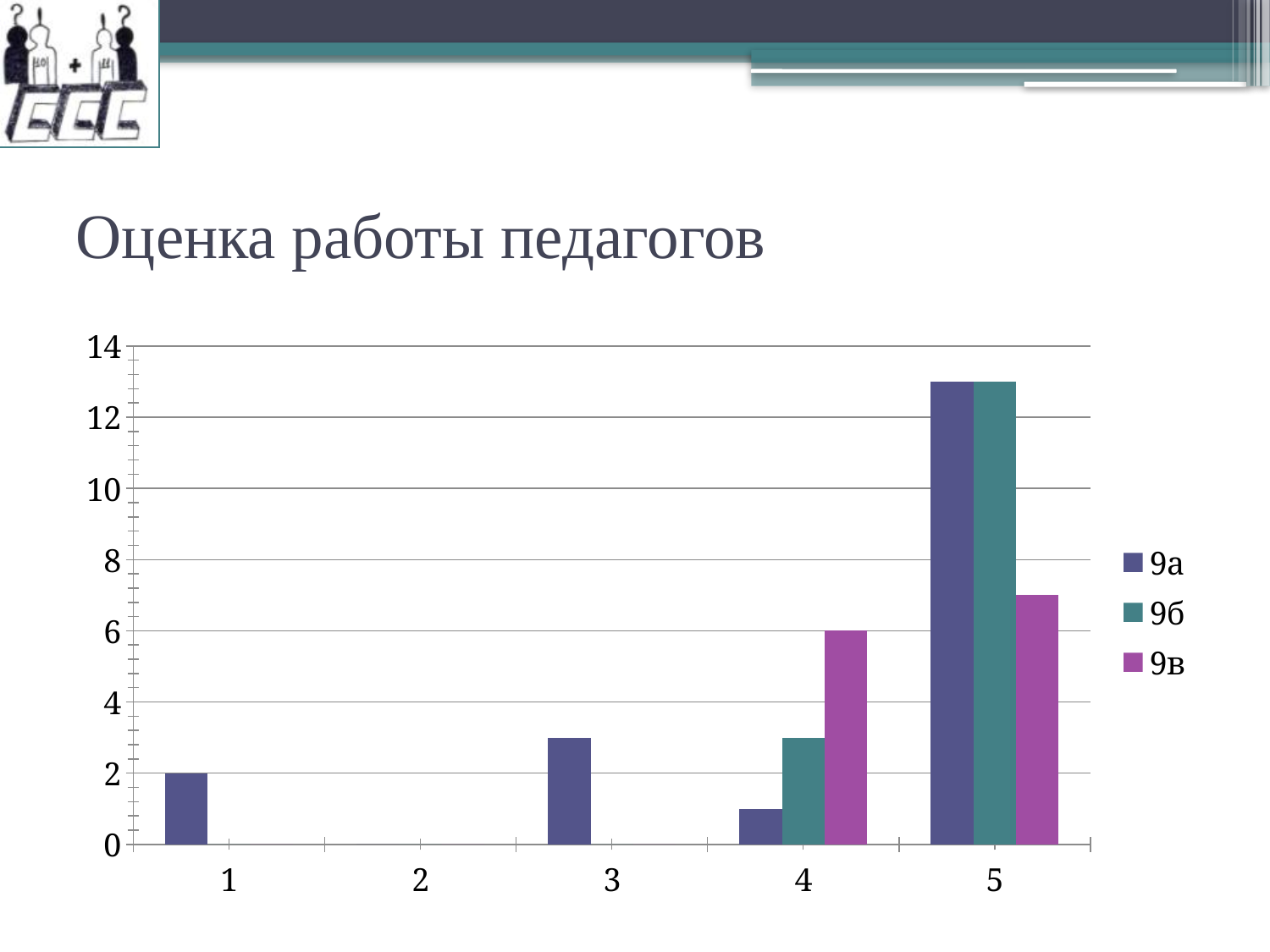
What is the value for series 9в at category 4? 6 Which category has the highest value for series 9а? 5 Is the value for series 9в at category 5 greater or less than 8? less How many series does the legend list? 3 What is the title of the chart? Оценка работы педагогов Is the value for series 9а at category 5 greater or less than 12? greater At category 5, which series has the smaller value, 9б or 9в? 9в Is the value for series 9б at category 4 greater or less than 4? less How many categories are shown on the x axis? 5 What kind of chart is shown on the slide? bar chart At category 4, which series has the larger value, 9а or 9в? 9в What is the value for series 9а at category 1? 2